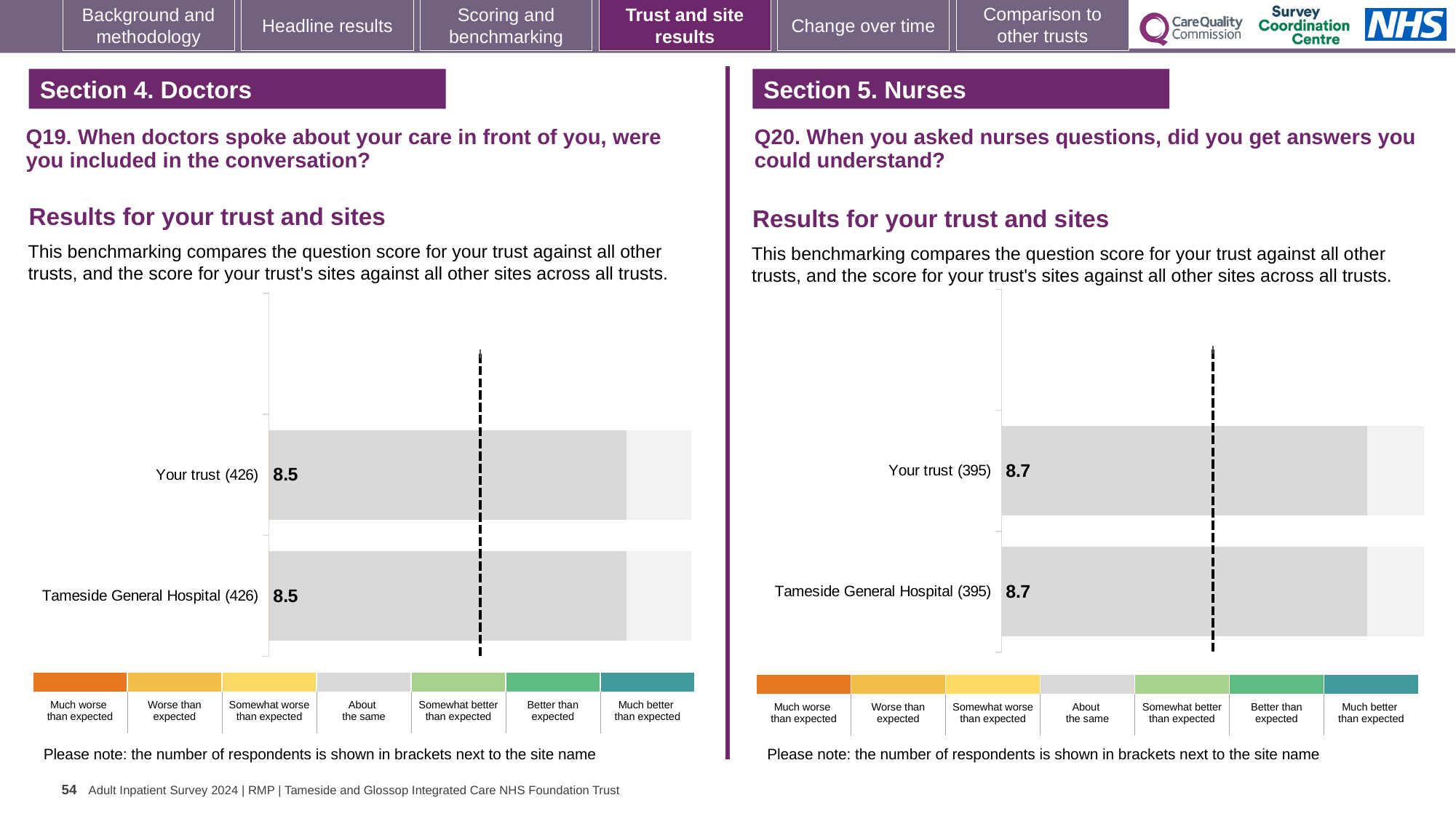
What type of chart is used for the Q19 results on the left? Bar chart How many bars are plotted in the Q20 chart on the right? 2 In the Q20 chart on the right, what is the score for Tameside General Hospital? 8.7 In the Q20 chart on the right, what is the difference between the score for Your trust and the score for Tameside General Hospital? 0 In the Q19 chart on the left, how many respondents are shown in brackets for Your trust? 426 In the Q19 chart on the left, what is the difference between the score for Your trust and the score for Tameside General Hospital? 0 How many bars are plotted in the Q19 chart on the left? 2 In the Q20 chart on the right, what is the score for Your trust? 8.7 In the Q20 chart on the right, how many respondents are shown in brackets for Tameside General Hospital? 395 In the Q19 chart on the left, what is the score for Tameside General Hospital? 8.5 Is the score for Your trust in the Q20 chart on the right larger or smaller than the score for Your trust in the Q19 chart on the left? Larger In the Q19 chart on the left, what is the score for Your trust? 8.5